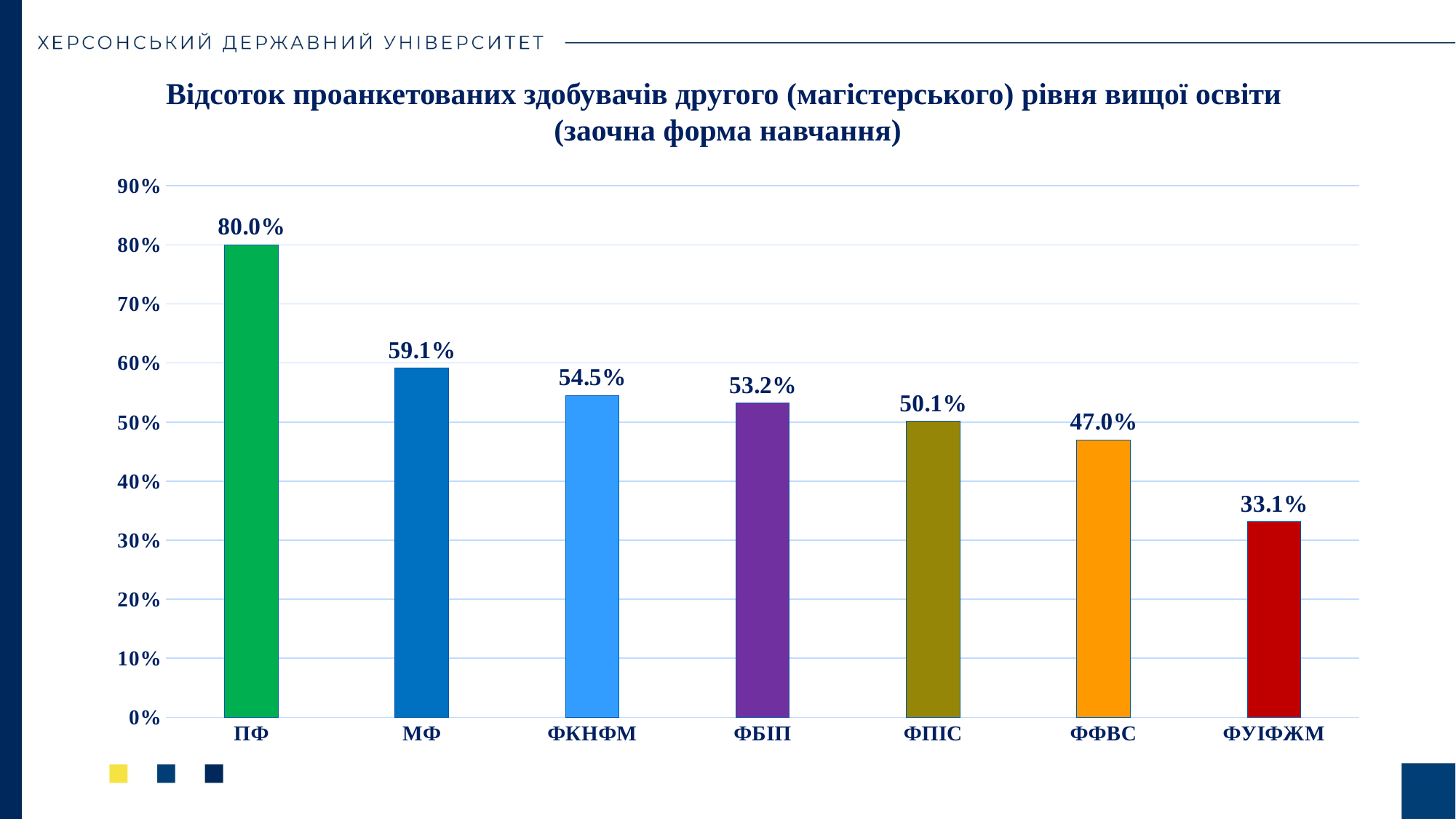
What is the difference between the values for ФФВС and ФУІФЖМ? 13.9% Which category has the lowest value? ФУІФЖМ What is the difference between the values for ПФ and МФ? 20.9% How many categories are shown on the x axis? 7 Is the value for ФФВС greater or less than 50%? less Which category has the highest value? ПФ Which is larger, the value for ФКНФМ or the value for ФПІС? ФКНФМ What is the value for ФБІП? 53.2% What is the value for ПФ? 80.0% What kind of chart is shown on the slide? bar chart What is the value for ФУІФЖМ? 33.1% Do the values rise or fall from left to right along the x axis? fall